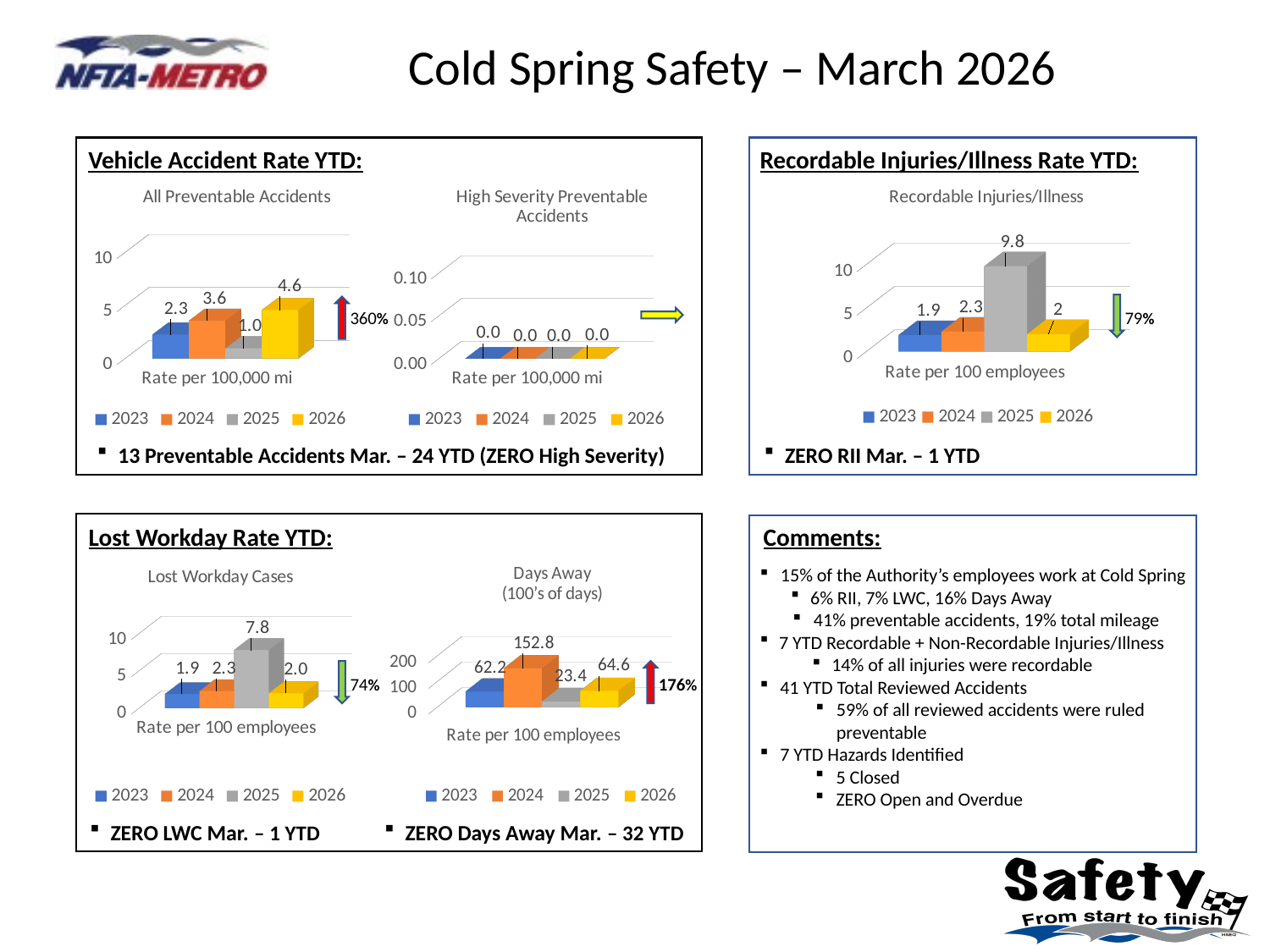
In the All Preventable Accidents chart, what is the value for 2026? 4.6 In the Days Away (100's of days) chart, what is the difference between the 2024 and 2023 values? 90.6 In the Days Away (100's of days) chart, what is the value for 2024? 152.8 In the All Preventable Accidents chart, which year has the lowest rate? 2025 How many series does the legend of the Lost Workday Cases chart list? 4 In the All Preventable Accidents chart, what is the difference between the 2026 and 2025 values? 3.6 In the All Preventable Accidents chart, which year has the highest rate? 2026 In the Recordable Injuries/Illness chart, which year has the highest value? 2025 In the Recordable Injuries/Illness chart, what is the value for 2025? 9.8 In the Lost Workday Cases chart, what is the value for 2025? 7.8 In the Days Away (100's of days) chart, is the value for 2024 greater or less than 100? greater In the Days Away (100's of days) chart, which year has the lowest value? 2025